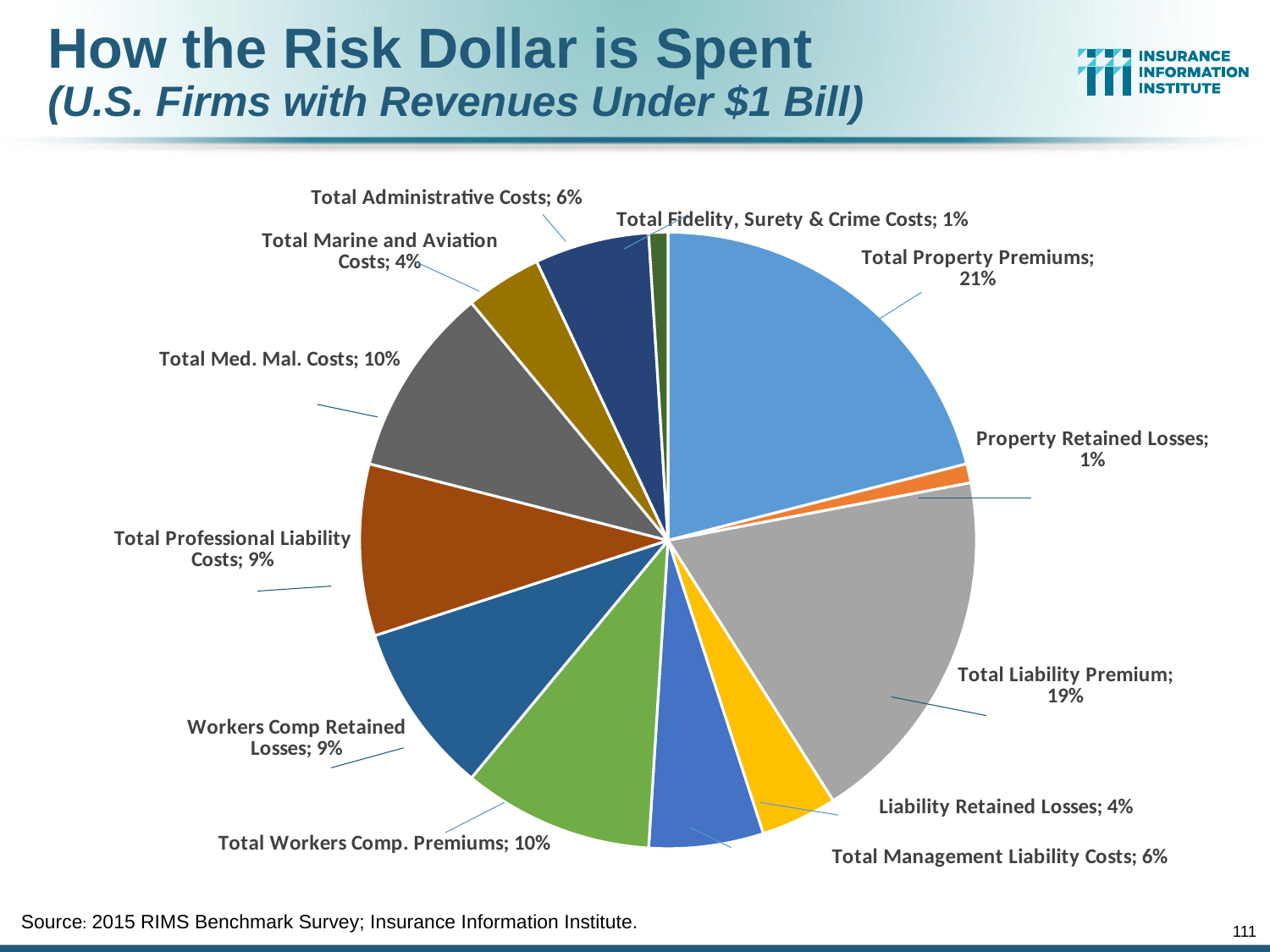
What is the difference between Total Property Premiums and Total Liability Premium? 2% What percentage is labelled for Total Marine and Aviation Costs? 4% Which category has the largest slice of the pie? Total Property Premiums What kind of chart is shown on the slide? Pie chart What is the value for Total Med. Mal. Costs? 10% What is the value for Workers Comp Retained Losses? 9% What percentage is shown for Total Liability Premium? 19% What share of the risk dollar goes to Total Property Premiums? 21% What is the title of the chart on the slide? How the Risk Dollar is Spent (U.S. Firms with Revenues Under $1 Bill) What is the combined share of Total Administrative Costs and Total Management Liability Costs? 12% Which is larger, Total Property Premiums or Total Liability Premium? Total Property Premiums How many slices does the pie chart have? 12